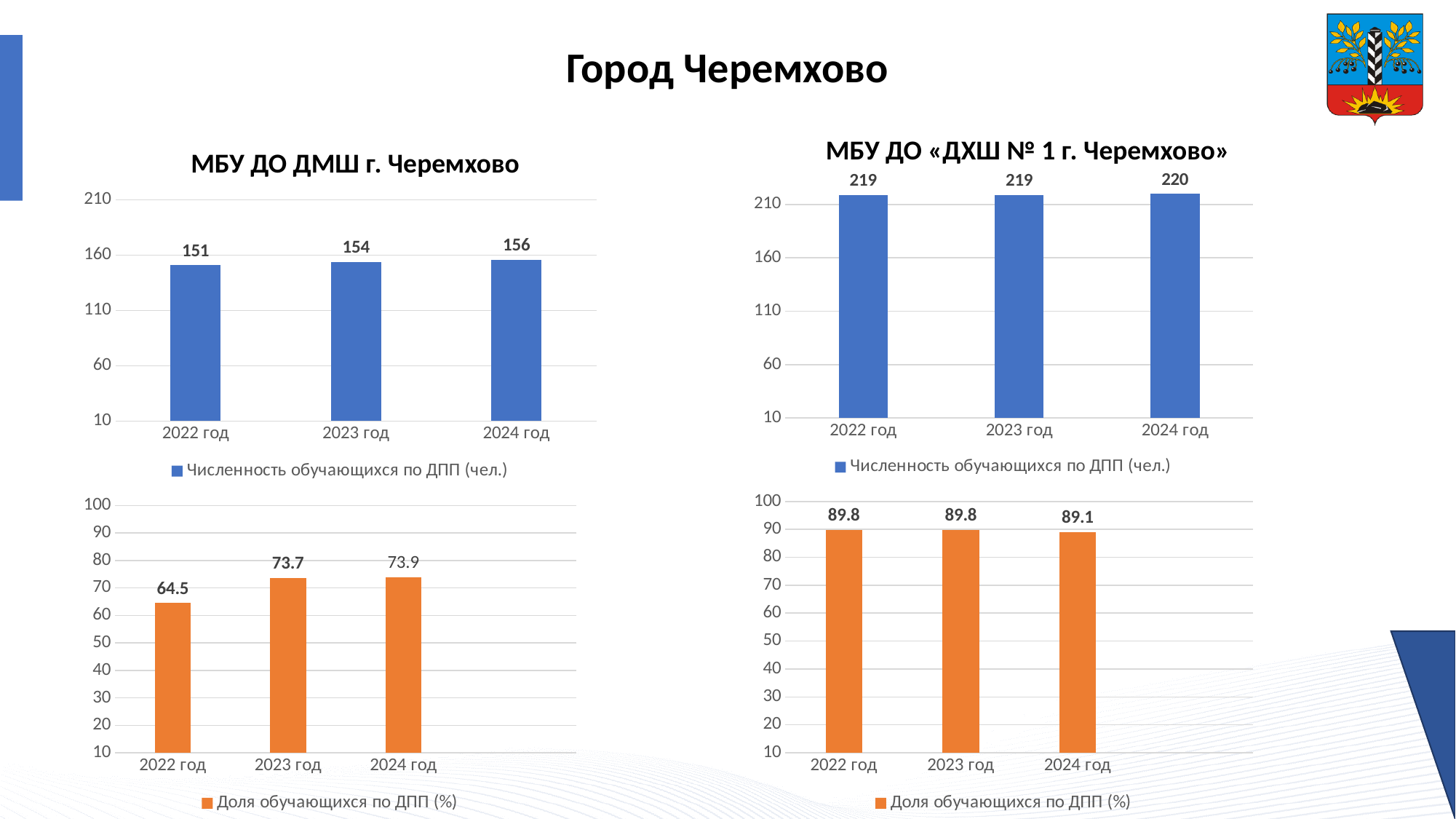
In the chart titled «МБУ ДО «ДХШ № 1 г. Черемхово»», what is the value for 2024 год? 220 In the bottom-right orange bar chart, what is the value for 2024 год? 89.1 In the chart titled «МБУ ДО ДМШ г. Черемхово», what is the difference between the values for 2024 год and 2022 год? 5 In the chart titled «МБУ ДО ДМШ г. Черемхово», which year has the highest value? 2024 год In the chart titled «МБУ ДО ДМШ г. Черемхово», what is the value for 2023 год? 154 In the bottom-left orange bar chart, what is the value for 2022 год? 64.5 How many years are shown on the x axis of the chart titled «МБУ ДО ДМШ г. Черемхово»? 3 In the bottom-left orange bar chart, which year has the lowest value? 2022 год In the bottom-right orange bar chart, which is larger: the value for 2022 год or the value for 2024 год? 2022 год In the chart titled «МБУ ДО «ДХШ № 1 г. Черемхово»», is the value for 2022 год greater or less than 160? greater What kind of chart is the chart titled «МБУ ДО «ДХШ № 1 г. Черемхово»»? bar chart In the bottom-left orange bar chart, do the values rise or fall from 2022 год to 2024 год? rise